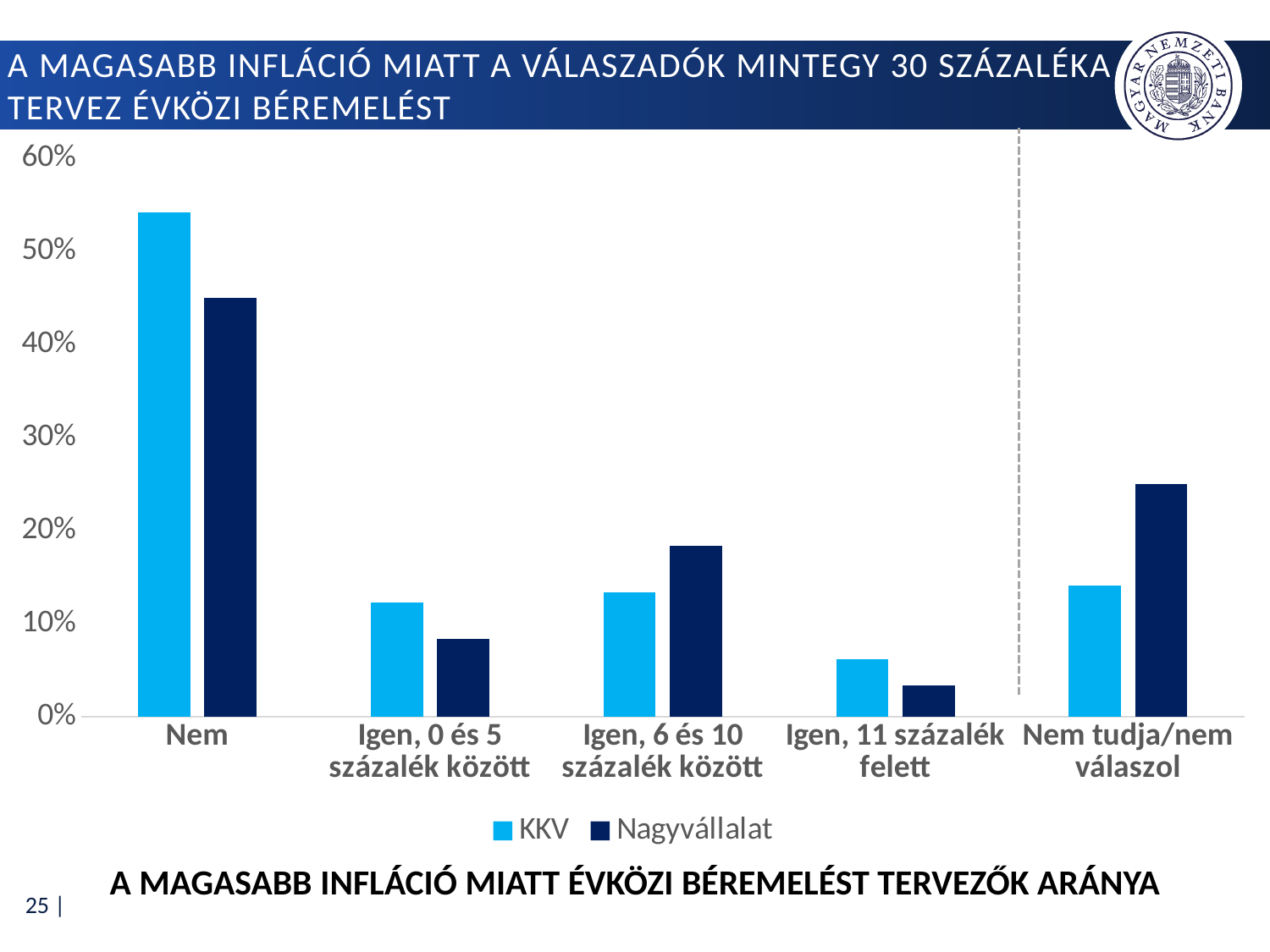
Is the Nagyvállalat value for Nem greater or less than 50%? less Is the Nagyvállalat value for Nem tudja/nem válaszol greater or less than 20%? greater Is the KKV value for Igen, 11 százalék felett greater or less than 10%? less How many categories are shown on the x axis? 5 Which category has the lowest Nagyvállalat value? Igen, 11 százalék felett What are the two series named in the legend? KKV and Nagyvállalat How many series does the legend list? 2 Which category has the highest KKV value? Nem What kind of chart is shown on the slide? bar chart For Igen, 0 és 5 százalék között, which series has the larger value, KKV or Nagyvállalat? KKV For Igen, 6 és 10 százalék között, which series has the larger value, KKV or Nagyvállalat? Nagyvállalat